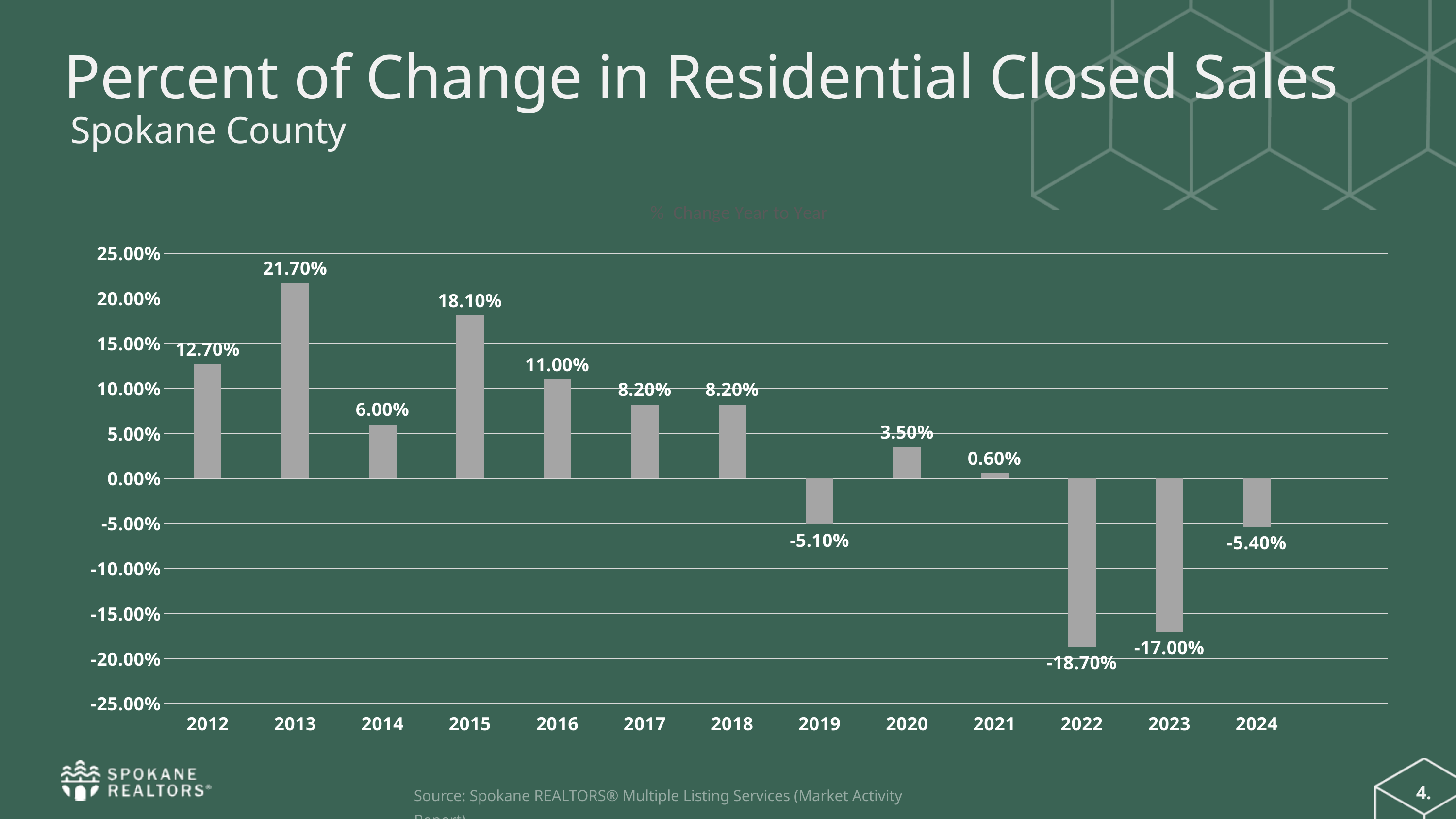
What kind of chart is shown on the slide? Bar chart Which year has the highest percent change? 2013 What is the value shown for 2021? 0.60% Which year has the lowest percent change? 2022 Which year has the larger value, 2016 or 2020? 2016 What is the subtitle shown under the slide title? Spokane County How many years are shown on the x axis? 13 What is the percent change in residential closed sales for 2013? 21.70% What is the value shown for 2024? -5.40% What is the difference between the values for 2013 and 2015? 3.60% What is the value shown for 2022? -18.70% Do the values generally rise or fall from 2015 to 2019? Fall